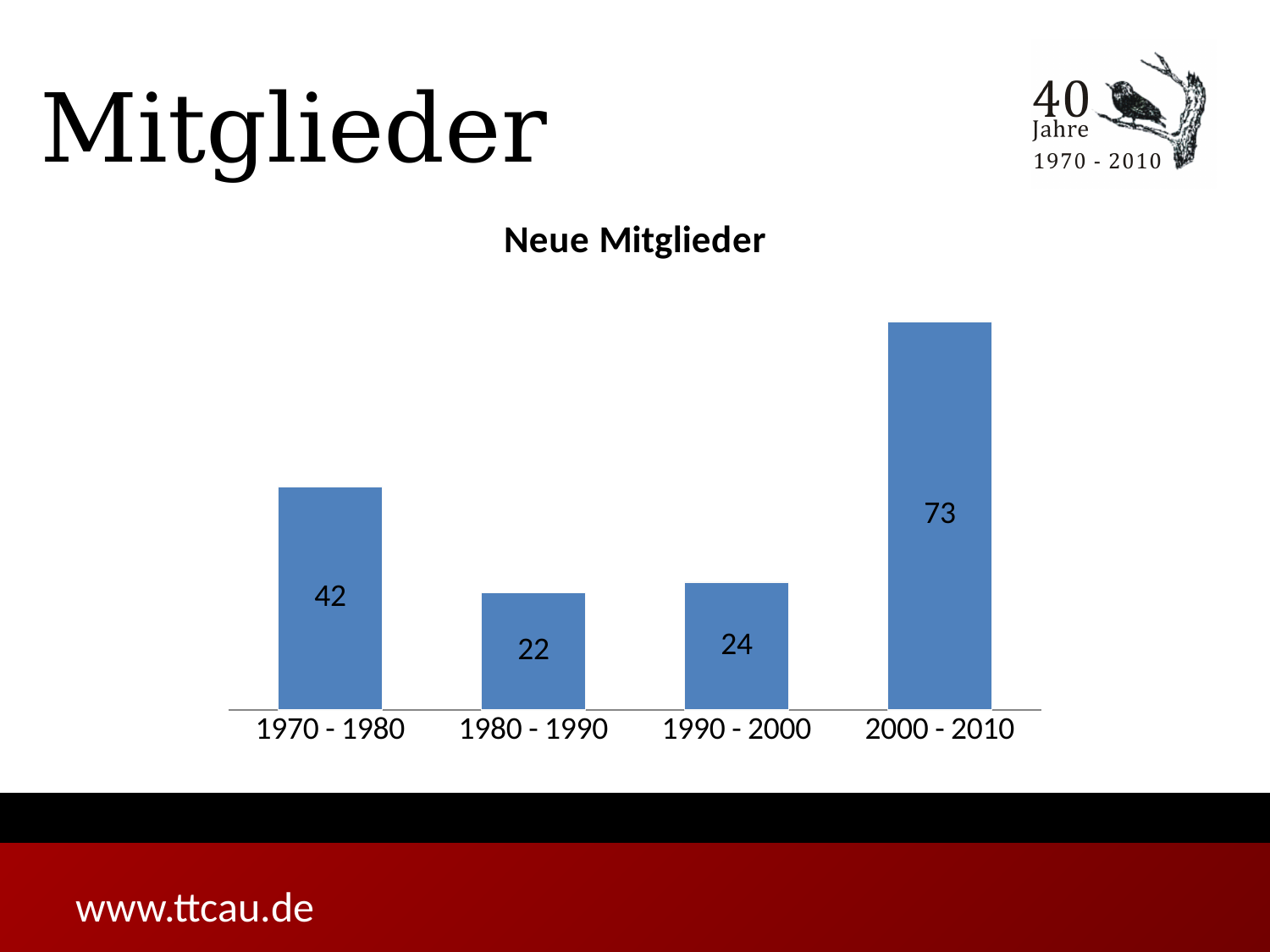
How many periods are shown in the chart? 4 Which is larger, the value for 1970 - 1980 or the value for 1990 - 2000? 1970 - 1980 What is the value for 1980 - 1990? 22 What is the title of the chart? Neue Mitglieder What is the value for 1990 - 2000? 24 What is the value for 1970 - 1980? 42 Which period has the highest value? 2000 - 2010 Which period has the lowest value? 1980 - 1990 What kind of chart is shown? bar chart What is the value for 2000 - 2010? 73 What is the difference between the values for 2000 - 2010 and 1970 - 1980? 31 What is the difference between the values for 1990 - 2000 and 1980 - 1990? 2